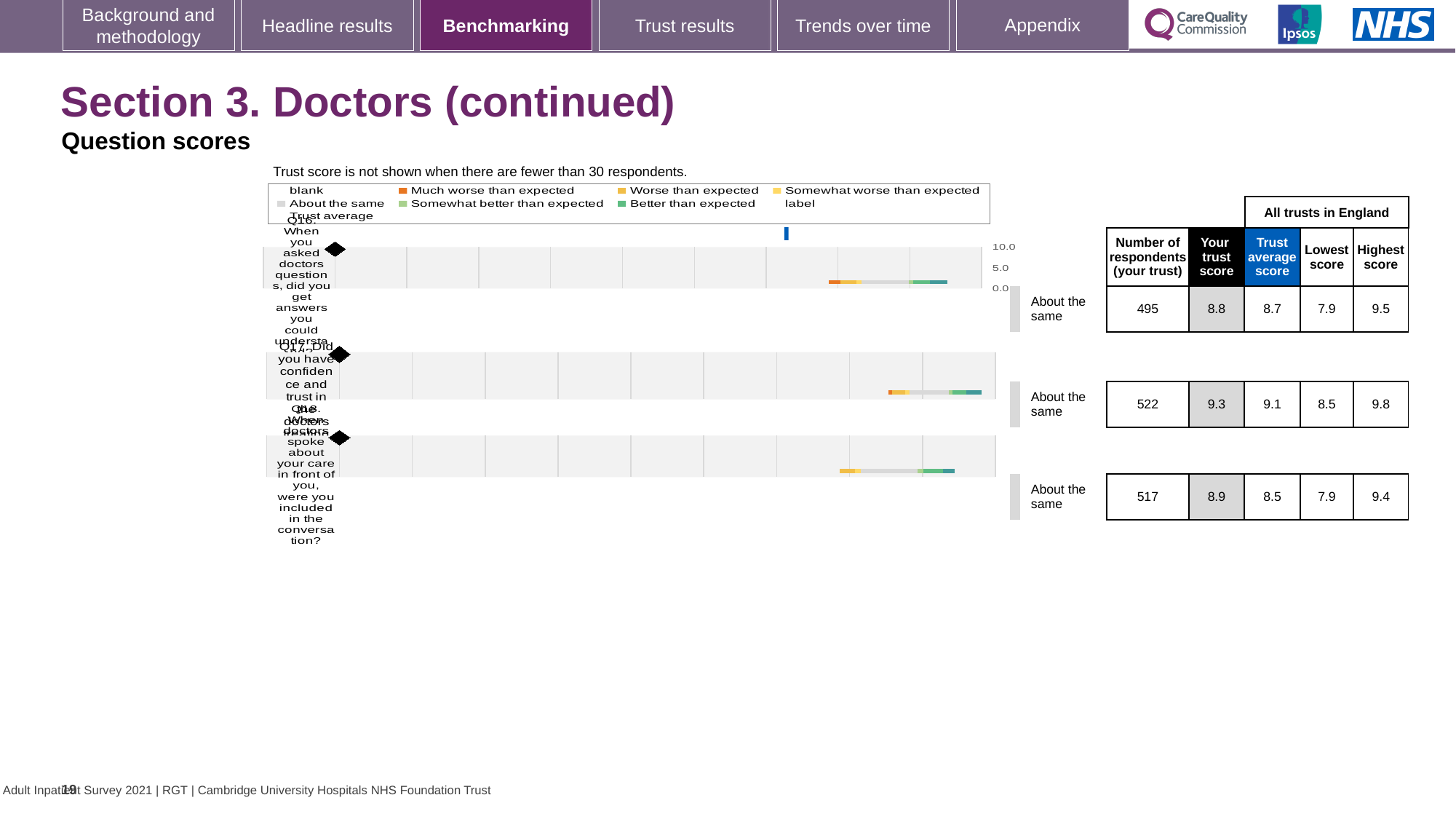
What is the number of respondents for Q16 (When you asked doctors questions, did you get answers you could understand)? 495 What is the lowest score across all trusts in England for Q17? 8.5 What is the highest score across all trusts in England for Q18 (When doctors spoke about your care in front of you, were you included in the conversation)? 9.4 Which of the three questions has the highest 'Your trust score'? Q17 For Q18, which is larger: the trust score or the trust average score? trust score Is the trust score for Q16 greater or less than 5.0 on the chart axis? greater Which of the three questions has the lowest 'Your trust score'? Q16 What is the difference between the trust score and the trust average score for Q17? 0.2 What is the 'Your trust score' for Q17 (Did you have confidence and trust in the doctors treating you)? 9.3 What kind of chart is used to show the question scores on this slide? bar chart What benchmark category is shown next to each of the three questions? About the same How many questions (bars) are plotted in the question scores chart? 3